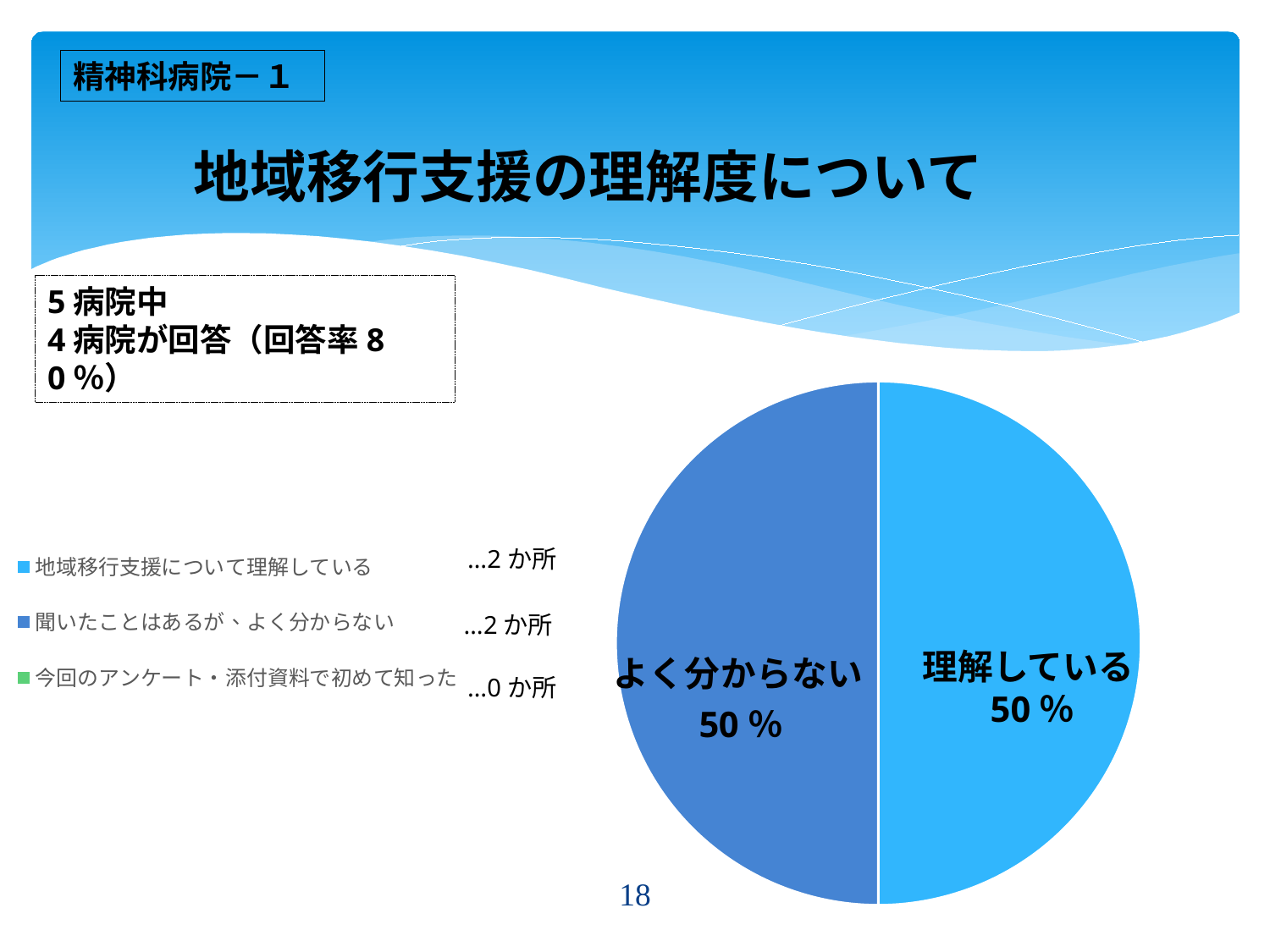
How many slices are visible in the pie chart? 2 What colour is the 理解している slice of the pie? light blue According to the legend, how many hospitals answered 地域移行支援について理解している? 2か所 According to the legend, how many hospitals answered 今回のアンケート・添付資料で初めて知った? 0か所 What share of the pie is labelled よく分からない? 50％ What share of the pie is labelled 理解している? 50％ Which legend entry has the lowest count? 今回のアンケート・添付資料で初めて知った What kind of chart is shown on the slide? pie chart What is the title of the slide containing the pie chart? 地域移行支援の理解度について How many entries does the legend list? 3 According to the legend, how many hospitals answered 聞いたことはあるが、よく分からない? 2か所